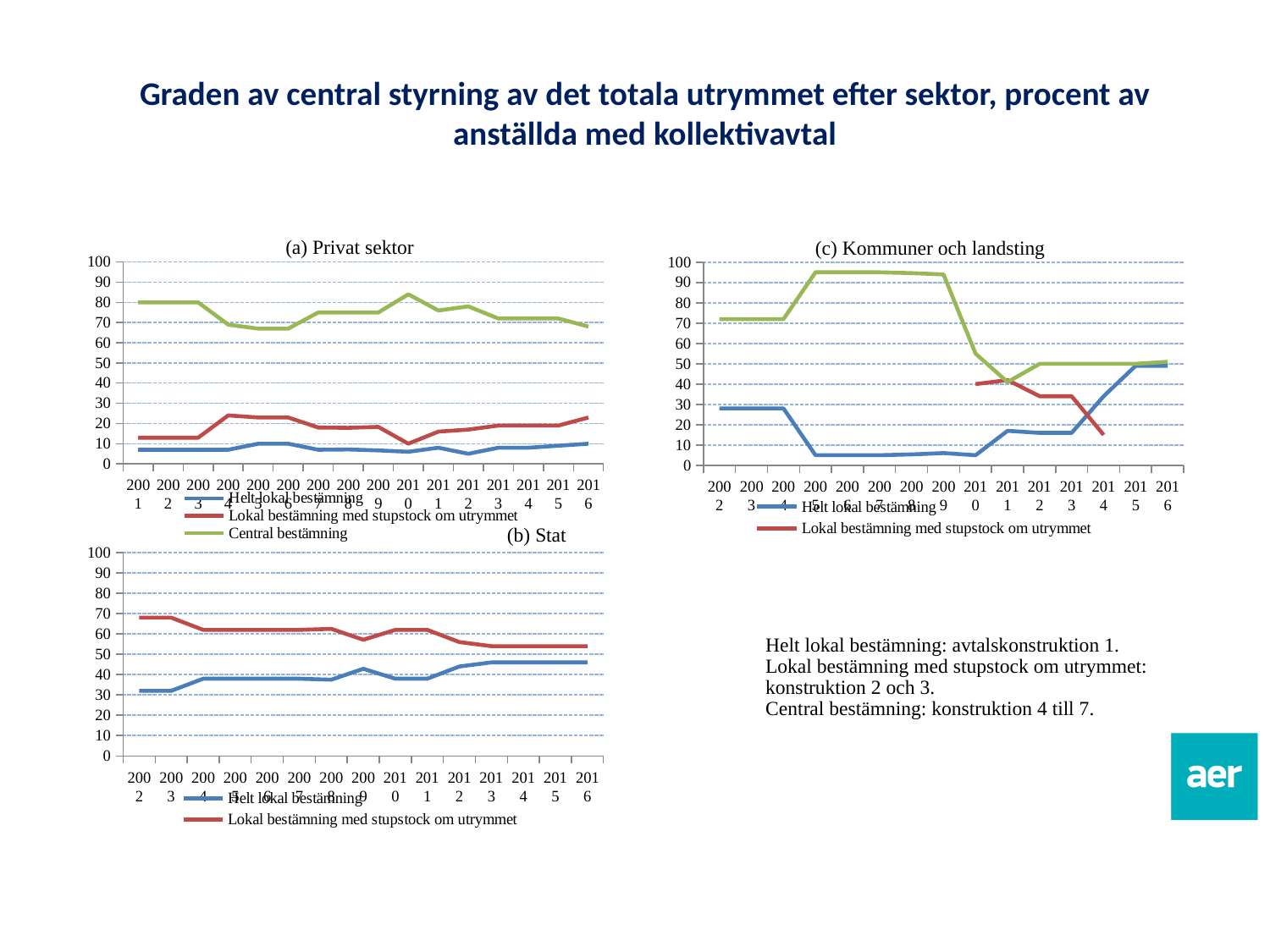
In the chart '(b) Stat', how many years are shown on the x axis? 15 In the chart '(a) Privat sektor', how many series does the legend list? 3 In the chart '(a) Privat sektor', is the value for Central bestämning in 2010 greater or less than 80? greater In the chart '(c) Kommuner och landsting', is the value for Helt lokal bestämning in 2005 greater or less than 10? less In the chart '(b) Stat', which series is higher in 2002, Helt lokal bestämning or Lokal bestämning med stupstock om utrymmet? Lokal bestämning med stupstock om utrymmet In the chart '(a) Privat sektor', how many years are shown on the x axis? 16 In the chart '(a) Privat sektor', which series has the highest value in 2001? Central bestämning In the chart '(c) Kommuner och landsting', does the green line rise or fall from 2008 to 2010? fall What kind of chart is '(a) Privat sektor'? line chart In the chart '(b) Stat', does Helt lokal bestämning rise or fall from 2002 to 2016? rise In the chart '(b) Stat', is the value for Lokal bestämning med stupstock om utrymmet in 2016 greater or less than 60? less What is the title of the chart in the top right of the slide? (c) Kommuner och landsting